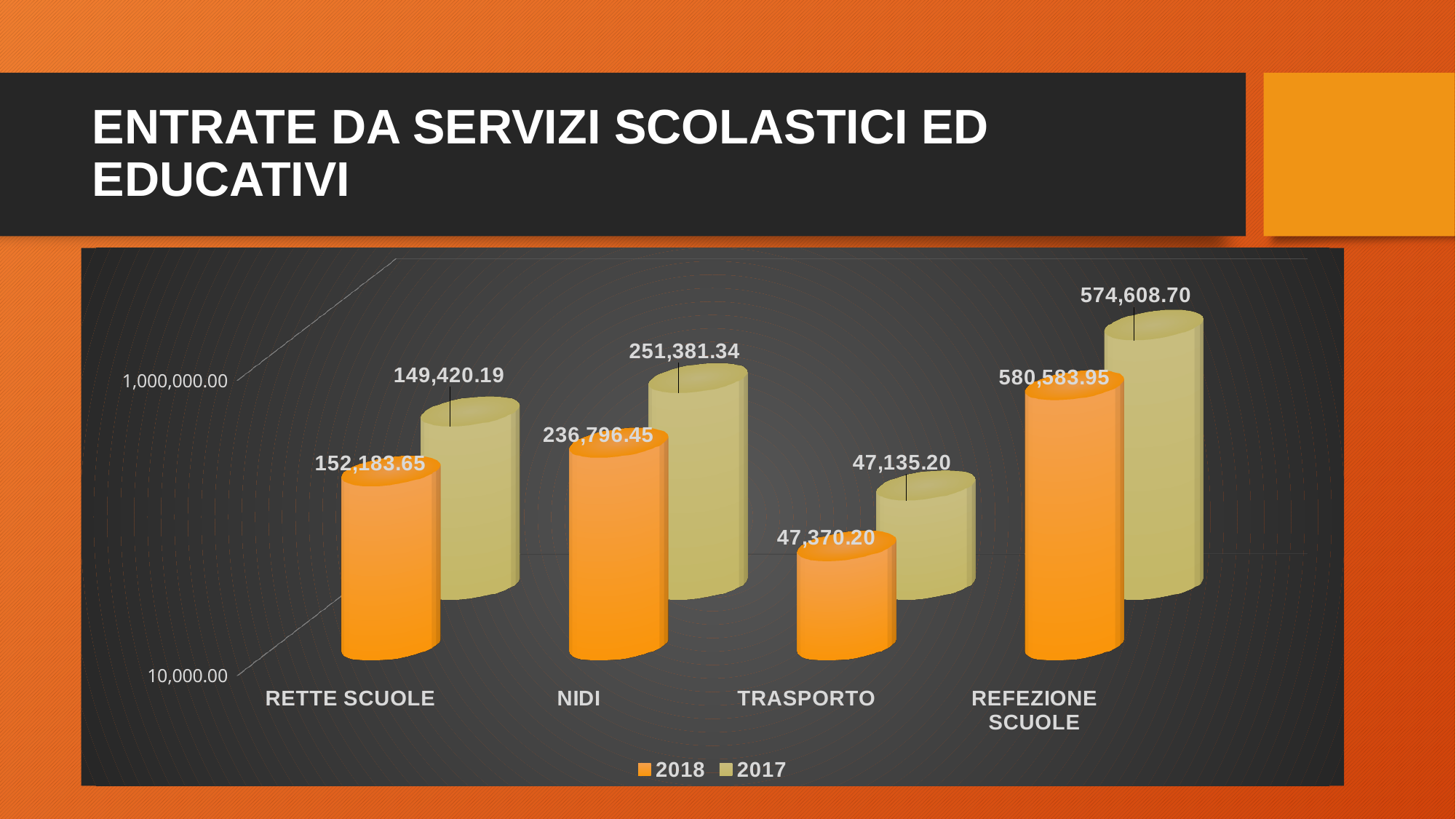
What is the difference between the 2017 and 2018 values for NIDI? 14,584.89 How many series does the legend list? 2 Which category has the lowest 2017 value? TRASPORTO What kind of chart is shown on the slide? Bar chart What is the 2017 value for REFEZIONE SCUOLE? 574,608.70 What is the 2018 value for NIDI? 236,796.45 What is the 2017 value for RETTE SCUOLE? 149,420.19 For NIDI, which year has the larger value, 2018 or 2017? 2017 Which category has the highest 2018 value? REFEZIONE SCUOLE How many categories are shown on the x axis? 4 What is the difference between the 2018 and 2017 values for REFEZIONE SCUOLE? 5,975.25 What is the 2018 value for TRASPORTO? 47,370.20